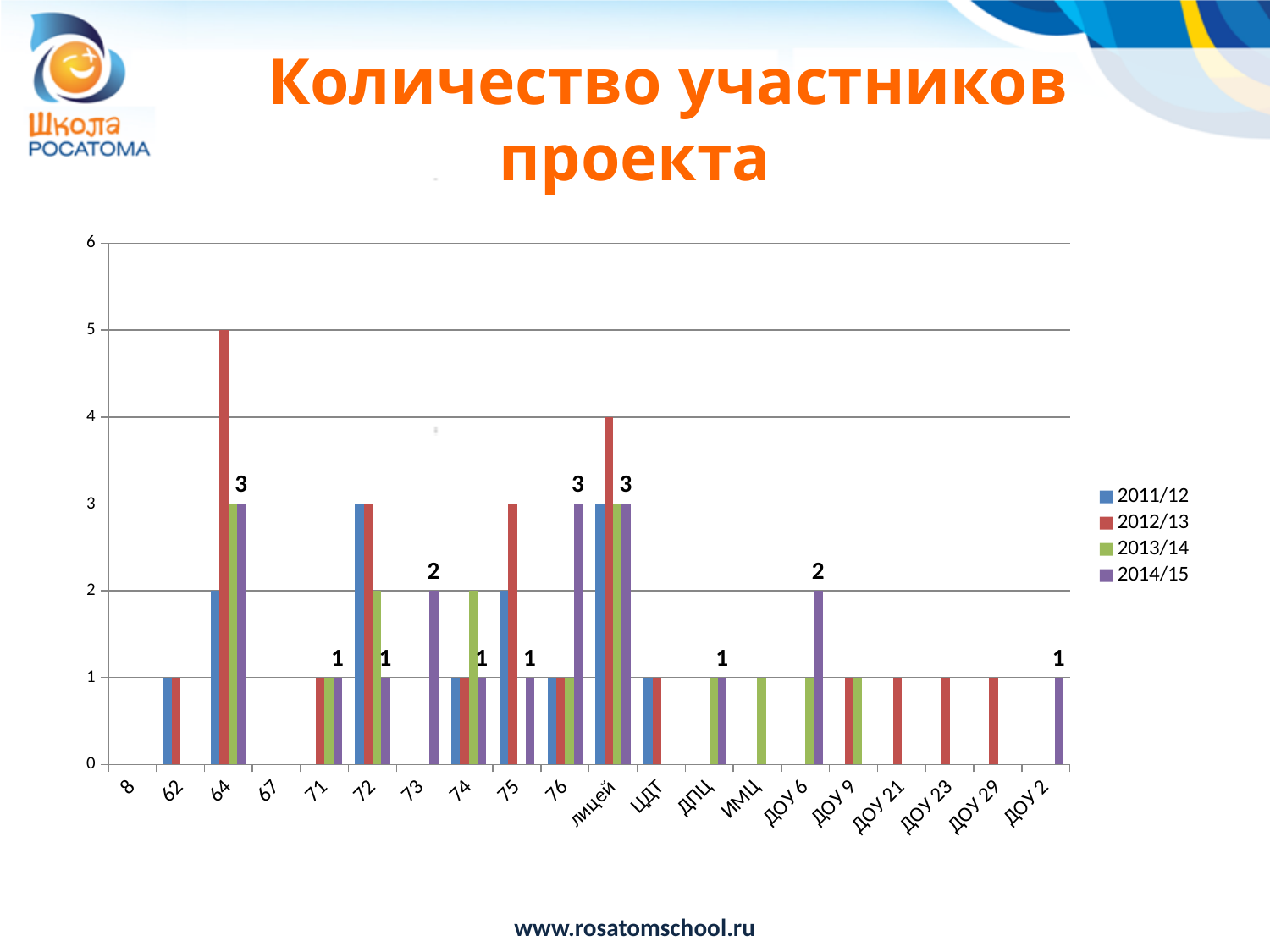
What is the 2014/15 value for category 73? 2 Which category has the highest 2012/13 value? 64 What is the 2014/15 value for category 64? 3 What is the difference between the 2014/15 values for category 64 and category 71? 2 What is the 2012/13 value for category 64? 5 What are the legend entries of the chart? 2011/12, 2012/13, 2013/14, 2014/15 What kind of chart is shown on the slide? bar chart What is the 2012/13 value for лицей? 4 How many series does the legend list? 4 How many categories are shown on the x axis? 20 What is the 2014/15 value for ДОУ 6? 2 Which has the larger 2012/13 value, category 64 or лицей? 64